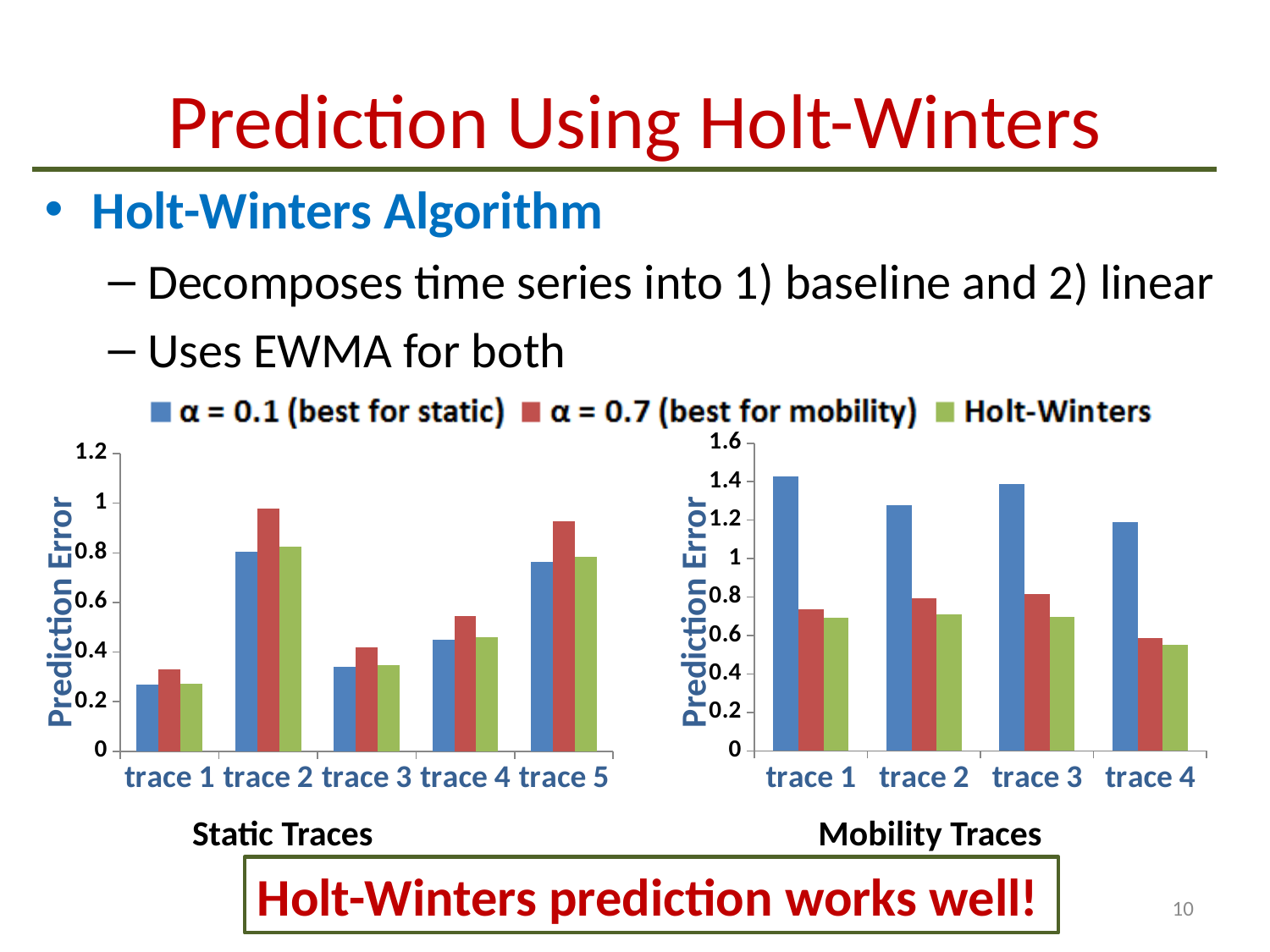
In the Mobility Traces chart, for trace 1, which is larger: the α = 0.1 value or the α = 0.7 value? α = 0.1 What kind of chart is the Static Traces chart? bar chart In the Mobility Traces chart, is the Holt-Winters value for trace 4 greater or less than 0.8? less How many series does the legend list for the charts? 3 What is the label of the y axis on the Mobility Traces chart? Prediction Error How many traces are shown on the x axis of the Static Traces chart? 5 In the Static Traces chart, is the α = 0.7 value for trace 2 greater or less than 0.8? greater In the Mobility Traces chart, is the α = 0.1 value for trace 1 greater or less than 1.2? greater In the Static Traces chart, which trace has the lowest Holt-Winters prediction error? trace 1 In the Mobility Traces chart, which trace has the lowest α = 0.1 prediction error? trace 4 How many traces are shown on the x axis of the Mobility Traces chart? 4